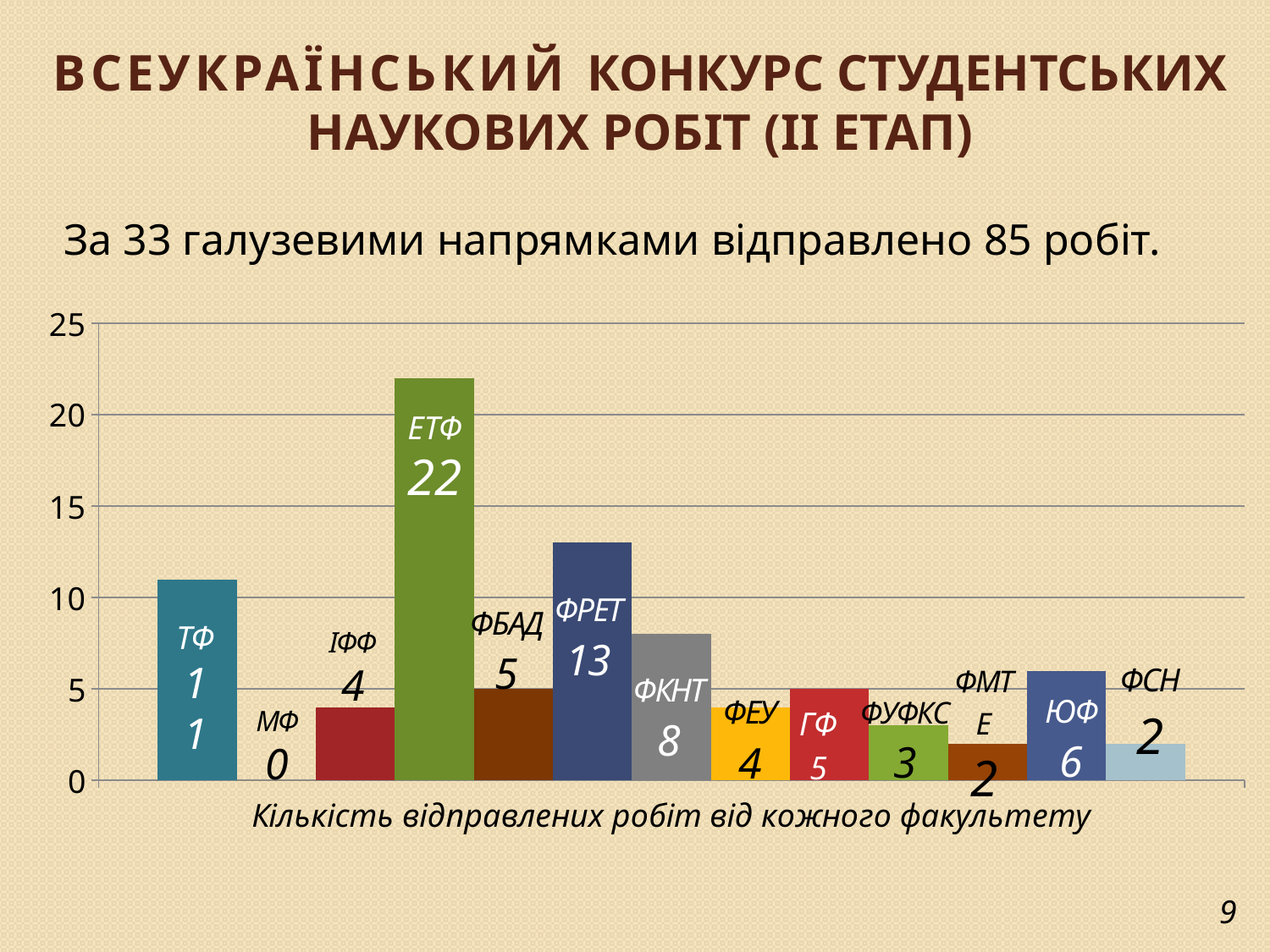
Is the value for ЕТФ greater or less than 20? greater How many faculties (bars) are shown in the chart? 13 What is the difference between the number of works from ЕТФ and from ФРЕТ? 9 What kind of chart is shown on the slide? bar chart How many works were submitted by ФРЕТ? 13 What is the x-axis title of the chart? Кількість відправлених робіт від кожного факультету Which faculty has the lowest number of submitted works? МФ How many works were submitted by ЕТФ? 22 Which faculty submitted more works, ФКНТ or ФБАД? ФКНТ Which faculty has the highest number of submitted works? ЕТФ How many works were submitted by ЮФ? 6 How many works were submitted by ТФ? 11